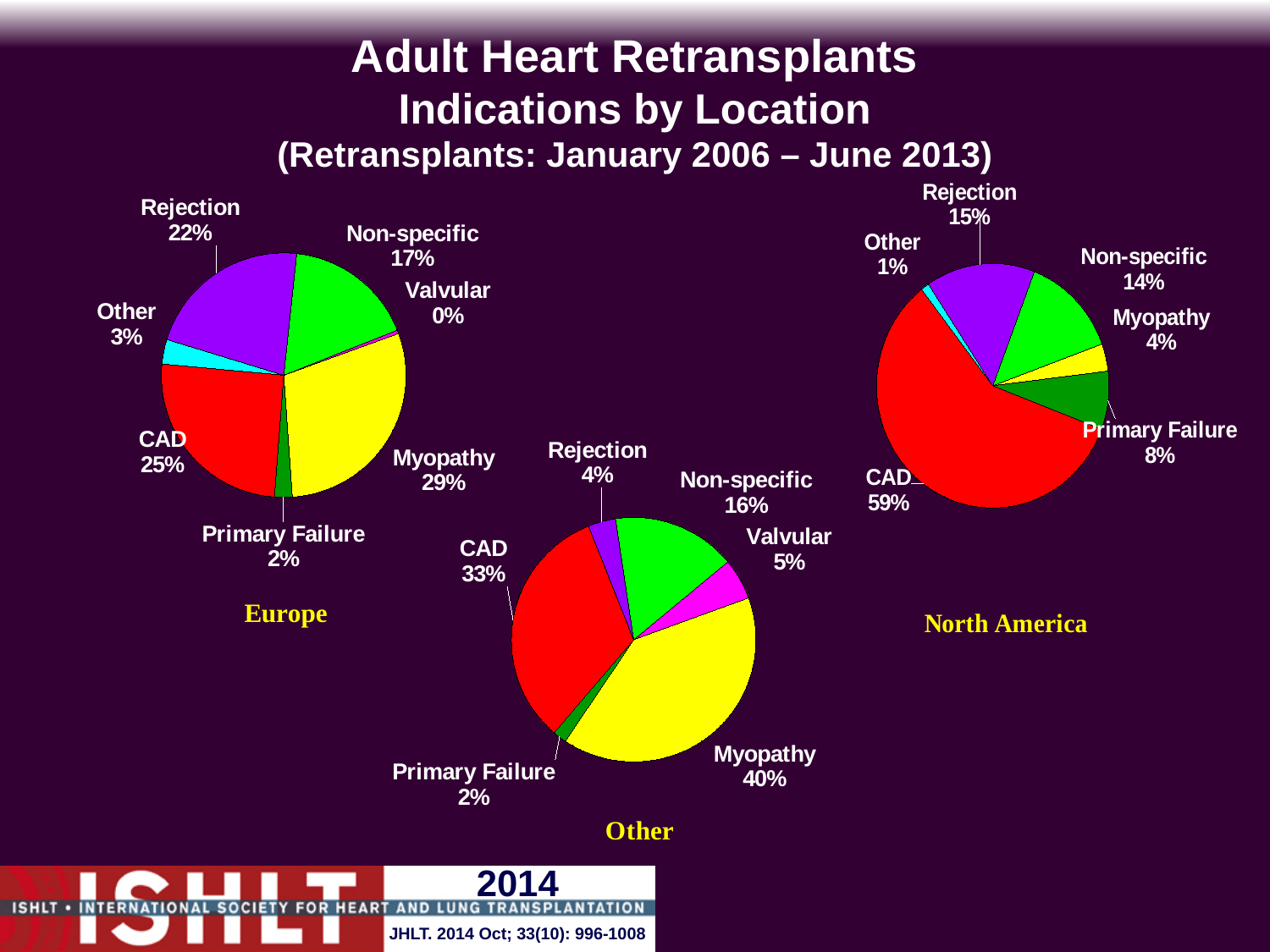
In the Other pie chart, which indication has the largest share? Myopathy How many slices are labelled in the Europe pie chart? 7 In the North America pie chart, which indication has the smallest share? Other In the Europe pie chart, which indication has the largest share? Myopathy In the North America pie chart, what is the difference between the Rejection share and the Non-specific share? 1% In the Europe pie chart, what percentage is shown for Myopathy? 29% In the Other pie chart, what percentage is shown for Valvular? 5% In the North America pie chart, what percentage is shown for CAD? 59% What is the share of Primary Failure in the North America pie chart? 8% What kind of chart is used to show the indications for each location? Pie chart In the Other pie chart, which is larger, the share for CAD or the share for Non-specific? CAD In the Europe pie chart, what is the difference between the CAD share and the Rejection share? 3%